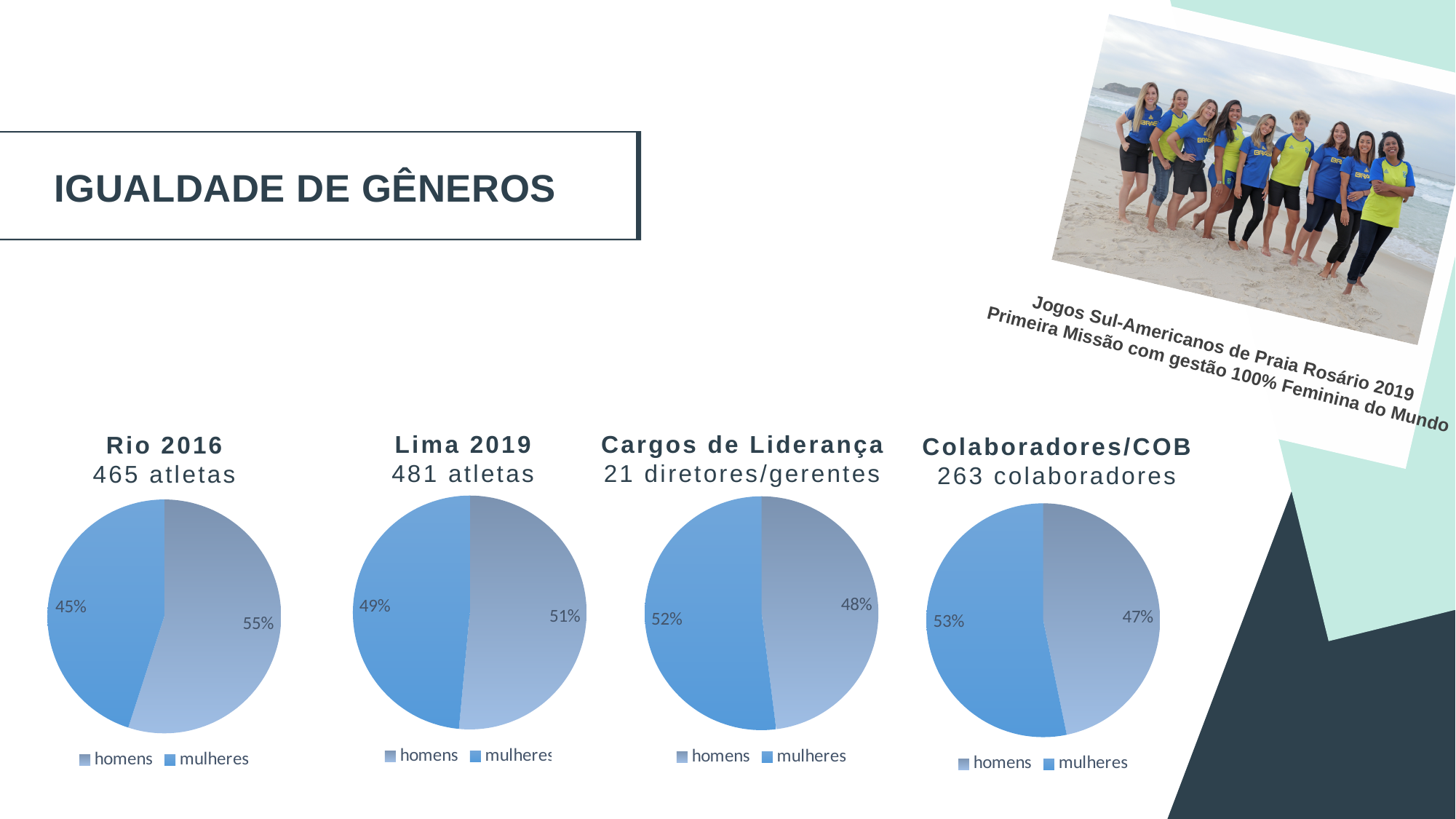
In the Lima 2019 pie chart, what share is shown for mulheres? 49% In the Rio 2016 pie chart, which slice is larger, homens or mulheres? homens How many pie charts are shown on the slide? 4 In the Rio 2016 pie chart, what share is shown for homens? 55% In the Rio 2016 pie chart, what share is shown for mulheres? 45% In the Colaboradores/COB pie chart, what share is shown for homens? 47% In the Cargos de Liderança pie chart, what is the difference in percentage points between mulheres and homens? 4 In the Cargos de Liderança pie chart, what share is shown for mulheres? 52% In the Colaboradores/COB pie chart, which slice is larger, homens or mulheres? mulheres What type of chart is used for Lima 2019? pie chart How many series does the legend of the Lima 2019 chart list? 2 In the Rio 2016 pie chart, what is the difference in percentage points between homens and mulheres? 10